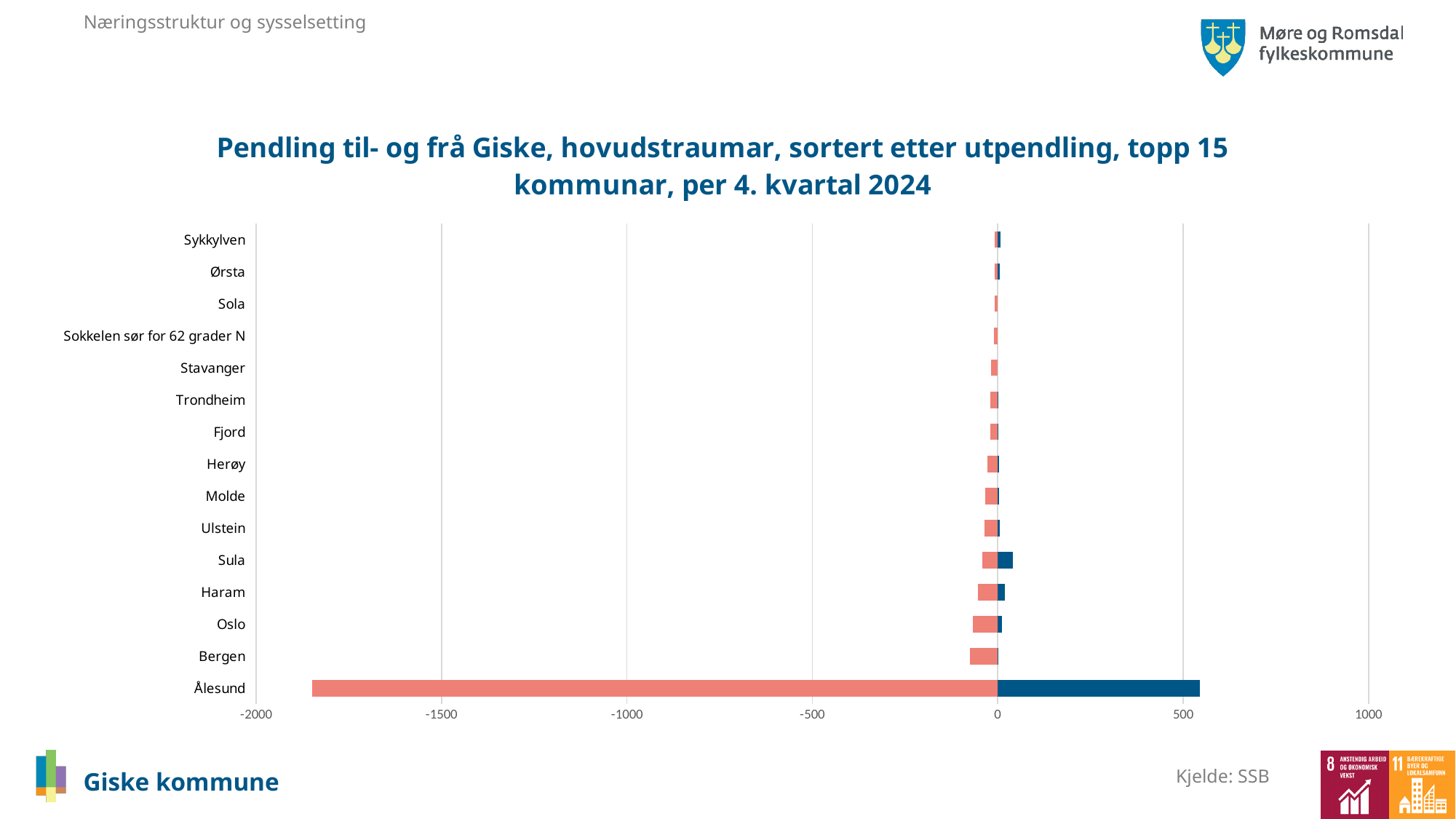
What kind of chart is shown on the slide? bar chart Is the red (negative) value for Ålesund greater or less than -1500? less Which has the longer blue bar, Sula or Haram? Sula What is the title of the chart? Pendling til- og frå Giske, hovudstraumar, sortert etter utpendling, topp 15 kommunar, per 4. kvartal 2024 Which municipality has the longest bars in both directions on the chart? Ålesund Which has the longer red bar, Ålesund or Bergen? Ålesund Is the blue (positive) value for Ålesund greater or less than 500? greater How many municipalities (categories) are listed on the chart? 15 Is the red (negative) value for Bergen greater or less than -500? greater Which has the longer blue bar, Sula or Ulstein? Sula What are the minimum and maximum values shown on the horizontal axis? -2000 and 1000 Going from the top category (Sykkylven) down to the bottom (Ålesund), do the red bars get longer or shorter? longer